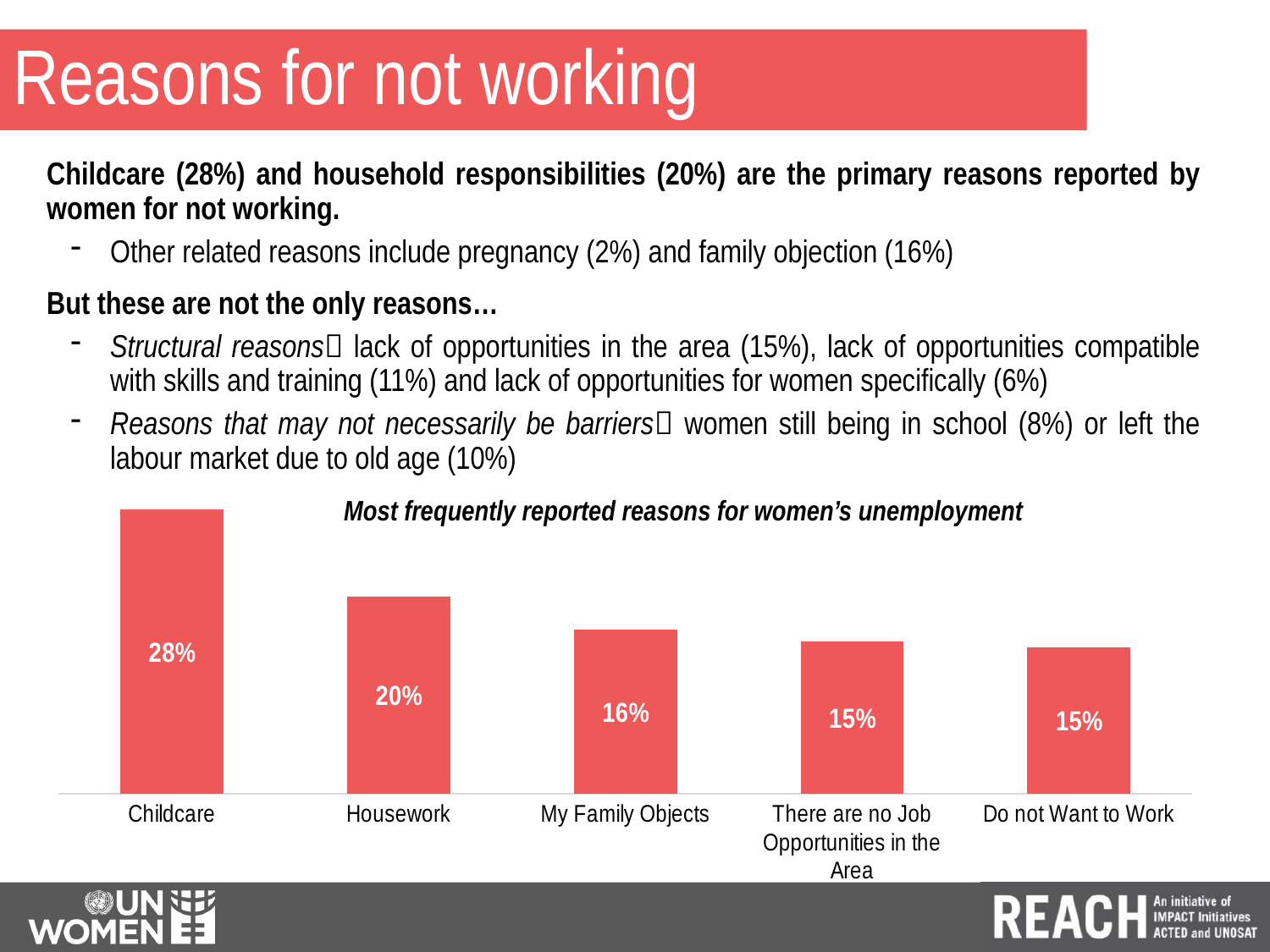
Which category has the highest value? Childcare What is the title of the chart? Most frequently reported reasons for women's unemployment What is the value for My Family Objects? 16% What is the value for Housework? 20% What is the difference between the values for Childcare and Housework? 8% Which is larger, the value for Housework or the value for Do not Want to Work? Housework Do the values rise or fall from left to right across the categories? Fall What kind of chart is shown on the slide? Bar chart What is the difference between the values for Housework and My Family Objects? 4% What is the value for There are no Job Opportunities in the Area? 15% How many categories are shown in the chart? 5 What is the value for Childcare? 28%